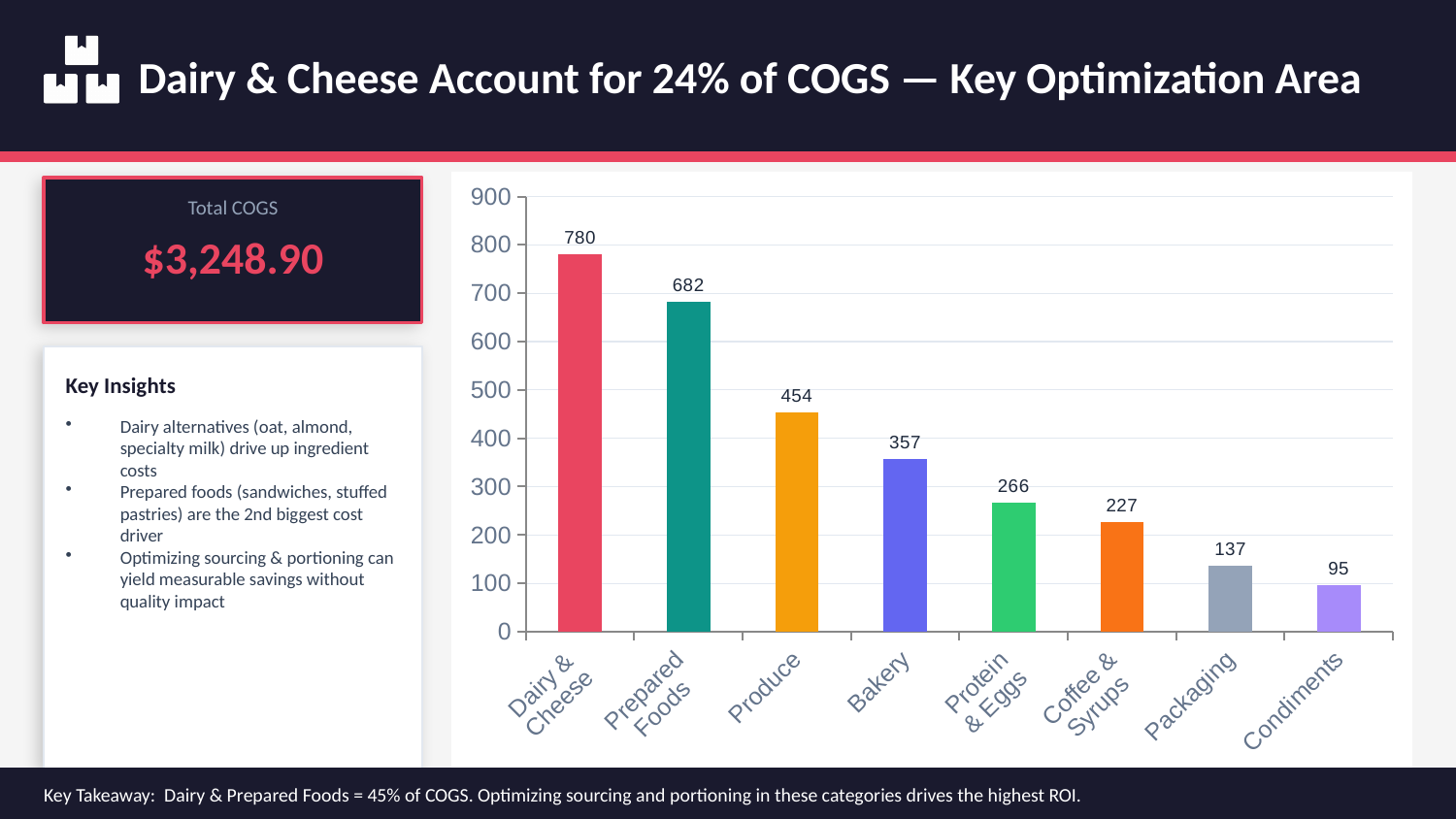
What is the value for Packaging? 137 What is the value for Dairy & Cheese? 780 How many categories are shown on the x axis? 8 Which category has the highest value? Dairy & Cheese What is the difference between Produce and Condiments? 359 Which is larger, Protein & Eggs or Coffee & Syrups? Protein & Eggs What is the value for Bakery? 357 Do the values rise or fall from left to right along the x axis? Fall What is the difference between Dairy & Cheese and Prepared Foods? 98 What kind of chart is shown on the slide? Bar chart Which category has the lowest value? Condiments Is the value for Produce greater or less than 400? greater